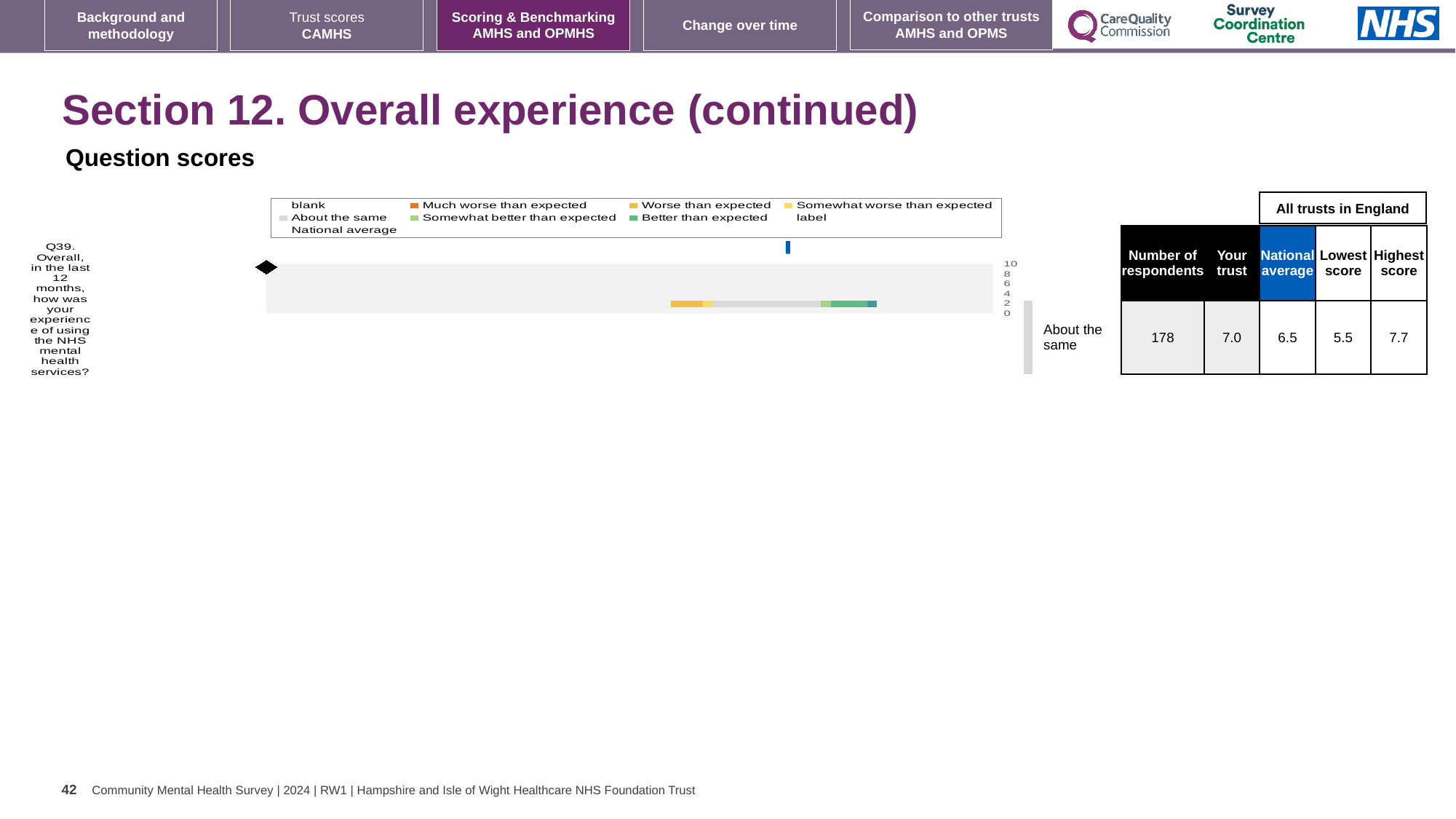
For Q39, what is the difference between the Highest score and the Lowest score in the table? 2.2 Which question number is plotted in the chart? Q39 How many survey questions are plotted in the chart? 1 In the table beside the chart, what is the Lowest score for Q39 across all trusts in England? 5.5 In the table beside the chart, how many respondents answered Q39? 178 In the table beside the chart, what is the National average score for Q39? 6.5 For Q39, which is larger: the 'Your trust' score or the National average? Your trust What category label is shown to the right of the Q39 bar? About the same How many entries does the chart legend list? 9 In the table beside the chart, what is the Highest score for Q39 across all trusts in England? 7.7 What kind of chart is shown on the slide for Q39? bar chart In the table beside the chart, what is the 'Your trust' score for Q39? 7.0